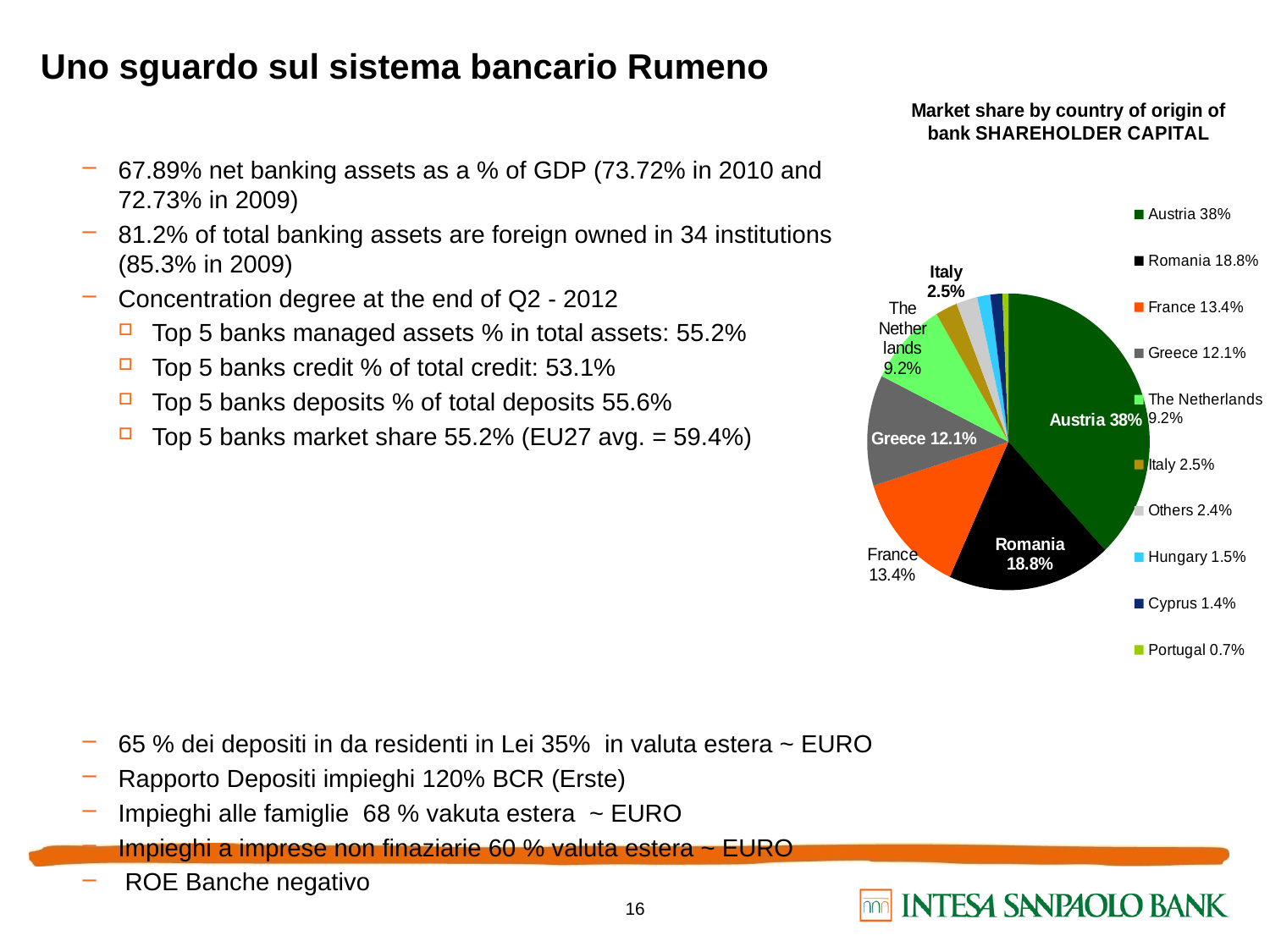
Which country has the smallest share in the pie chart? Portugal What is the title of the chart on the slide? Market share by country of origin of bank SHAREHOLDER CAPITAL What kind of chart is shown on the slide? pie chart Which country has the largest share in the pie chart? Austria What is the market share for The Netherlands in the pie chart? 9.2% What is the market share for Romania in the pie chart? 18.8% Which has a larger share in the pie chart, France or Greece? France What is the market share for Austria in the pie chart? 38% What is the difference between the shares of Austria and Romania in the pie chart? 19.2% What is the market share for Portugal in the pie chart? 0.7% What is the difference between the shares of Hungary and Cyprus in the pie chart? 0.1% How many slices does the pie chart have? 10